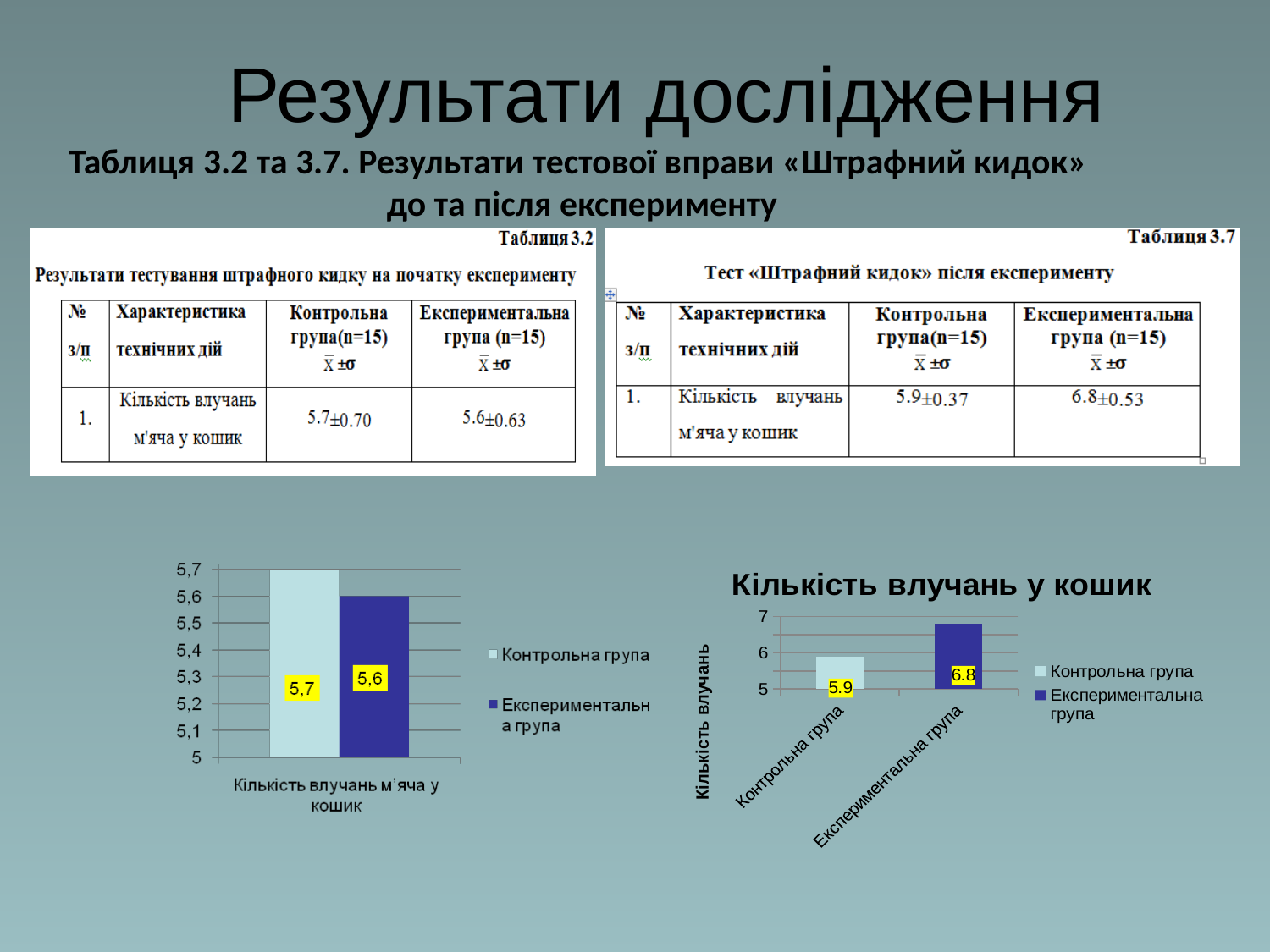
In the bottom-left chart, what is the value for Контрольна група? 5,7 In the chart titled «Кількість влучань у кошик», what is the value for Експериментальна група? 6.8 In the bottom-left chart, how many series does the legend list? 2 In the chart titled «Кількість влучань у кошик», which group has the lower value? Контрольна група In the bottom-left chart, what is the difference between the Контрольна група and Експериментальна група values? 0,1 In the chart titled «Кількість влучань у кошик», is the value for Контрольна група greater or less than 6? less In the chart titled «Кількість влучань у кошик», what is the value for Контрольна група? 5.9 In the bottom-left chart, what is the value for Експериментальна група? 5,6 What kind of chart is the bottom-left chart? bar chart In the chart titled «Кількість влучань у кошик», what is the difference between the Експериментальна група and Контрольна група values? 0.9 What is the y-axis label of the chart titled «Кількість влучань у кошик»? Кількість влучань In the bottom-left chart, which group has the higher value? Контрольна група